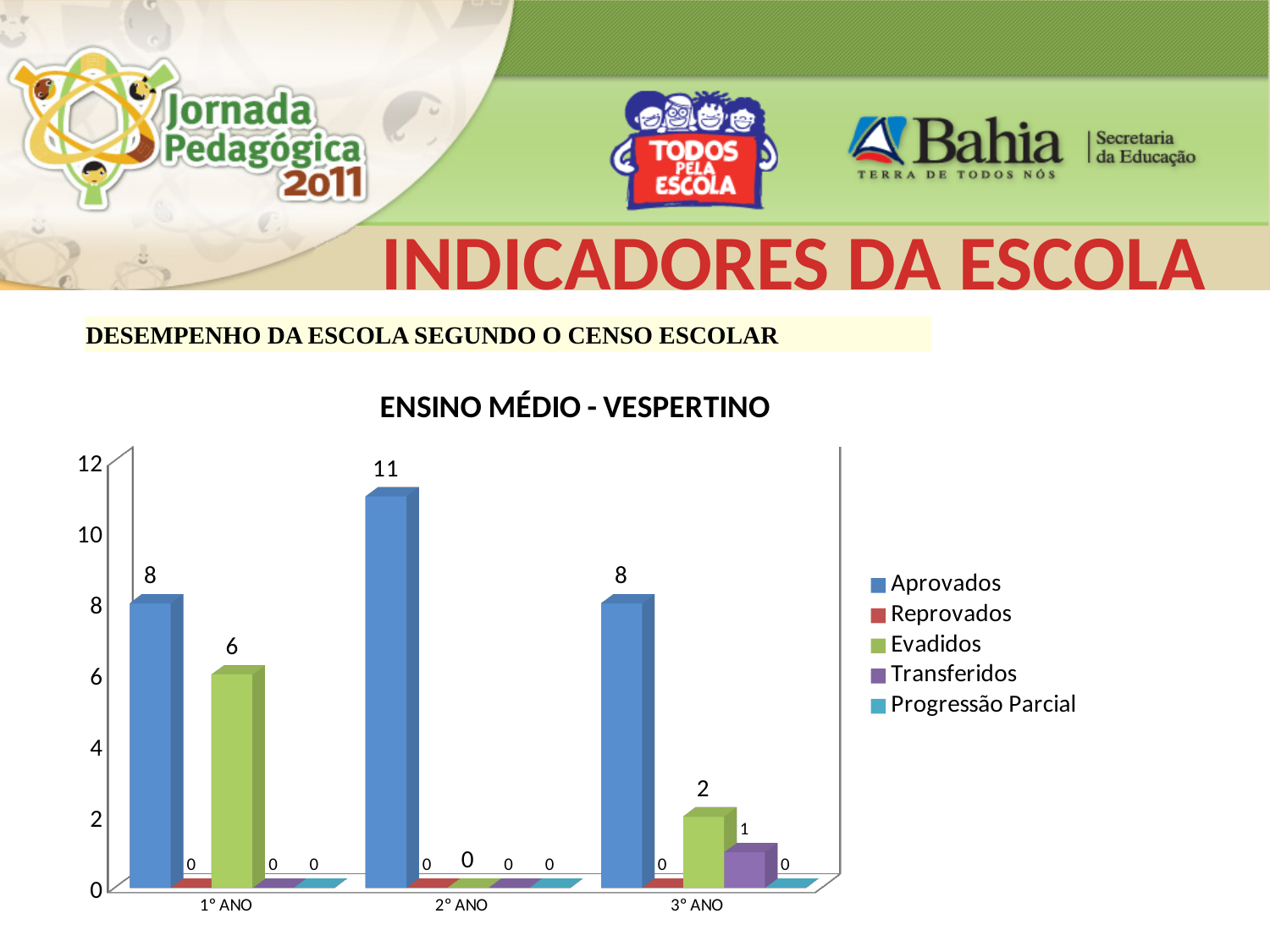
What kind of chart is shown on the slide? Bar chart What is the difference between Aprovados in 2° ANO and Aprovados in 1° ANO? 3 What is the value for Aprovados in 2° ANO? 11 Is the value for Aprovados in 2° ANO greater or less than 10? greater What is the value for Evadidos in 3° ANO? 2 How many year categories are shown on the x axis? 3 Which is larger: Evadidos in 1° ANO or Evadidos in 3° ANO? Evadidos in 1° ANO How many series does the legend list? 5 What is the title of the chart? ENSINO MÉDIO - VESPERTINO What is the value for Evadidos in 1° ANO? 6 Which year has the highest value for Aprovados? 2° ANO What is the value for Transferidos in 3° ANO? 1